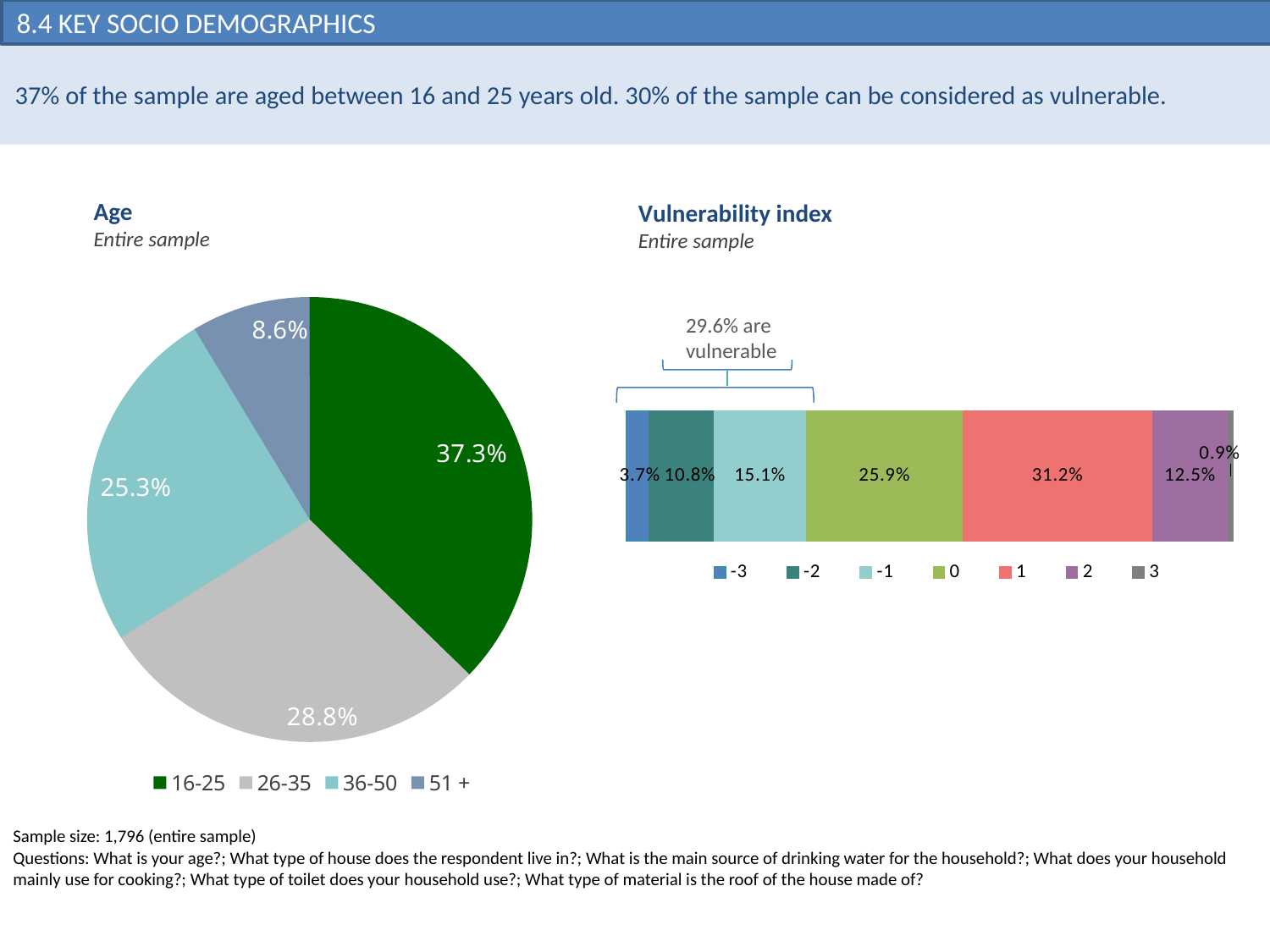
How many series does the legend of the Vulnerability index chart list? 7 How many age groups does the legend of the Age pie chart list? 4 In the Vulnerability index chart, what is the value for index 1? 31.2% In the Age pie chart, what is the difference between the shares for 26-35 and 36-50? 3.5% In the Vulnerability index chart, what is the value for index -3? 3.7% In the Age pie chart, which age group has the smallest share? 51 + In the Age pie chart, what share of the sample is aged 51 +? 8.6% In the Vulnerability index chart, which index value has the largest share? 1 In the Age pie chart, which age group has the largest share? 16-25 In the Vulnerability index chart, which is larger, the value for index 0 or the value for index 2? 0 In the Age pie chart, what share of the sample is aged 16-25? 37.3% What kind of chart is the Age chart? Pie chart